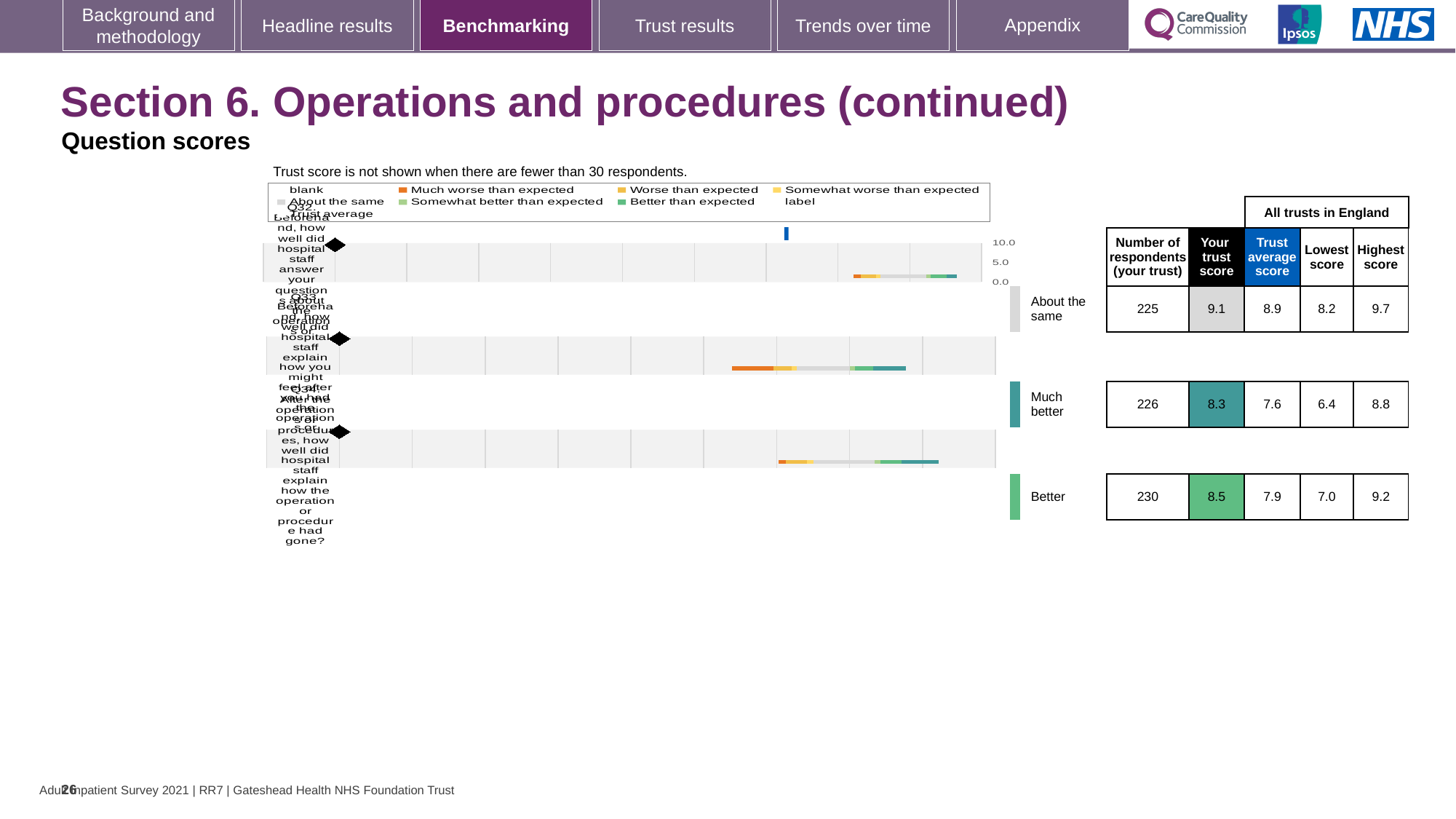
What is the 'Highest score' for the row rated 'About the same'? 9.7 Which row has the highest 'Your trust score'? About the same What is 'Your trust score' for the row rated 'Much better'? 8.3 How many respondents (your trust) are shown for the row rated 'About the same'? 225 What is the 'Lowest score' for the row rated 'Much better'? 6.4 What kind of chart is shown on the slide? Bar chart For the row rated 'Much better', what is the difference between 'Your trust score' and the 'Trust average score'? 0.7 What is the 'Trust average score' for the row rated 'Better'? 7.9 For the row rated 'Better', what is the difference between the 'Highest score' and the 'Lowest score'? 2.2 How many question rows are shown in the chart? 3 For the row rated 'Better', which is larger: 'Your trust score' or the 'Trust average score'? Your trust score Which row has the lowest number of respondents? About the same